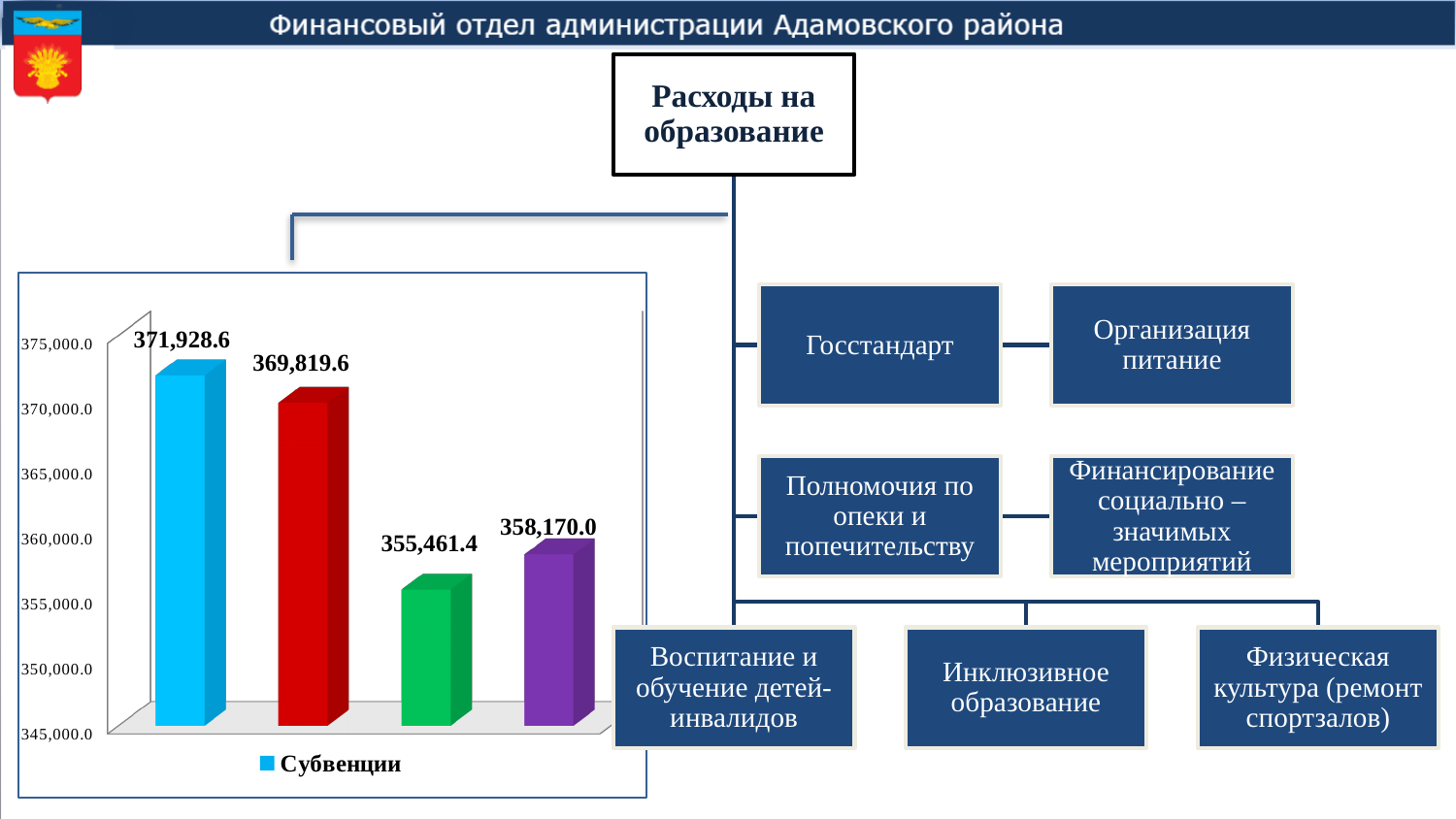
What is the value shown on the fourth (purple) bar? 358,170.0 What is the difference between the first (blue) bar and the third (green) bar? 16,467.2 Which bar has the highest value? the first (blue) bar, 371,928.6 What is the value shown on the first (blue) bar? 371,928.6 How many series does the chart legend list? 1 How many bars are plotted in the chart? 4 What is the value shown on the second (red) bar? 369,819.6 Which bar has the lowest value? the third (green) bar, 355,461.4 What is the legend entry of the chart? Субвенции Is the value of the fourth (purple) bar greater or less than 360,000.0? less What is the value shown on the third (green) bar? 355,461.4 What type of chart is shown on the slide? bar chart